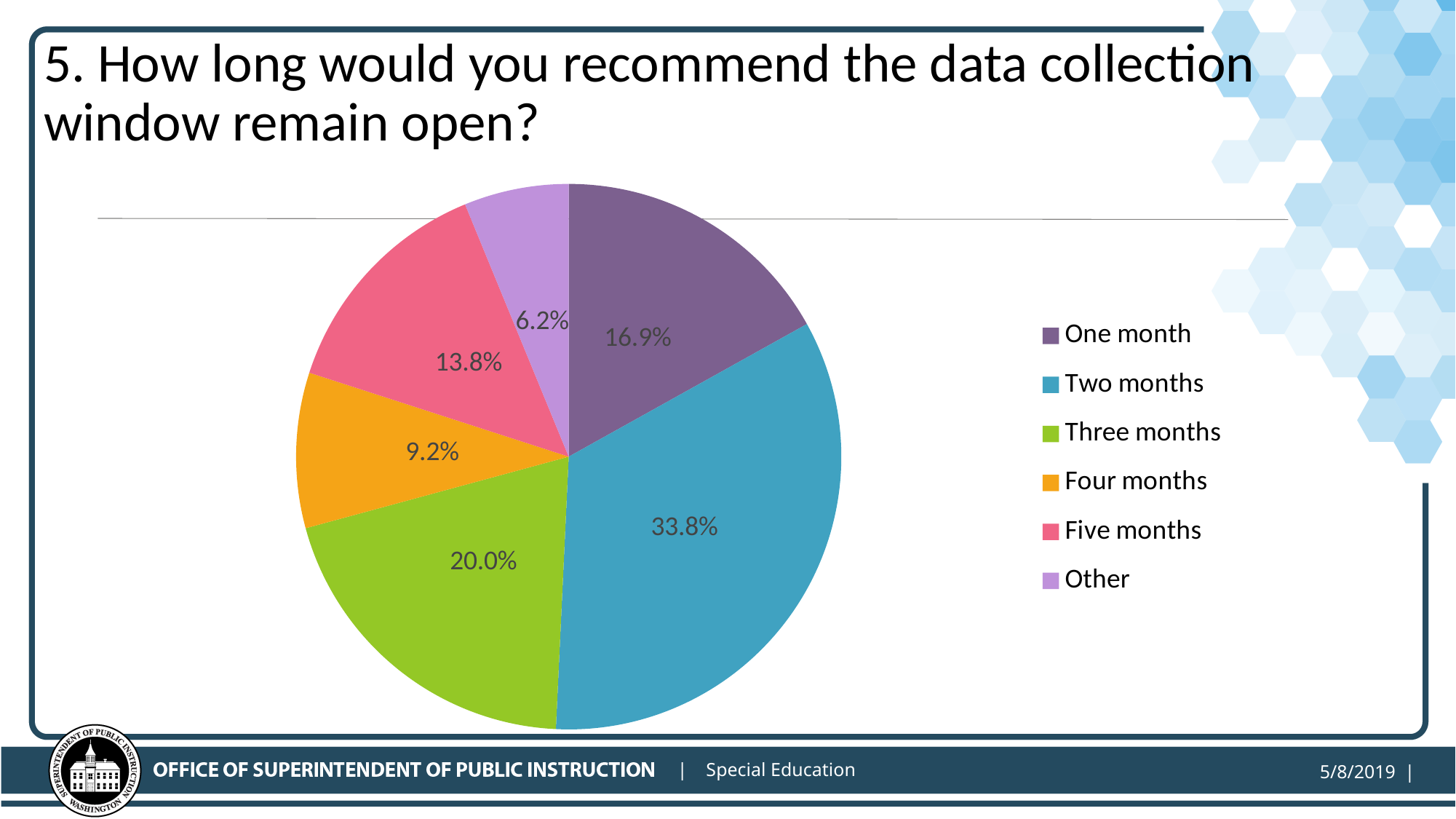
Which is larger, the share for three months or the share for five months? Three months How many categories does the legend list? 6 Which option has the largest share of the pie? Two months What kind of chart is shown on the slide? pie chart What share of respondents recommended three months? 20.0% Which option has the smallest share of the pie? Other What share of respondents recommended two months? 33.8% What share of respondents recommended five months? 13.8% What is the difference in percentage points between the two months share and the one month share? 16.9 What share of respondents chose Other? 6.2% What share of respondents recommended four months? 9.2% What share of respondents recommended one month? 16.9%